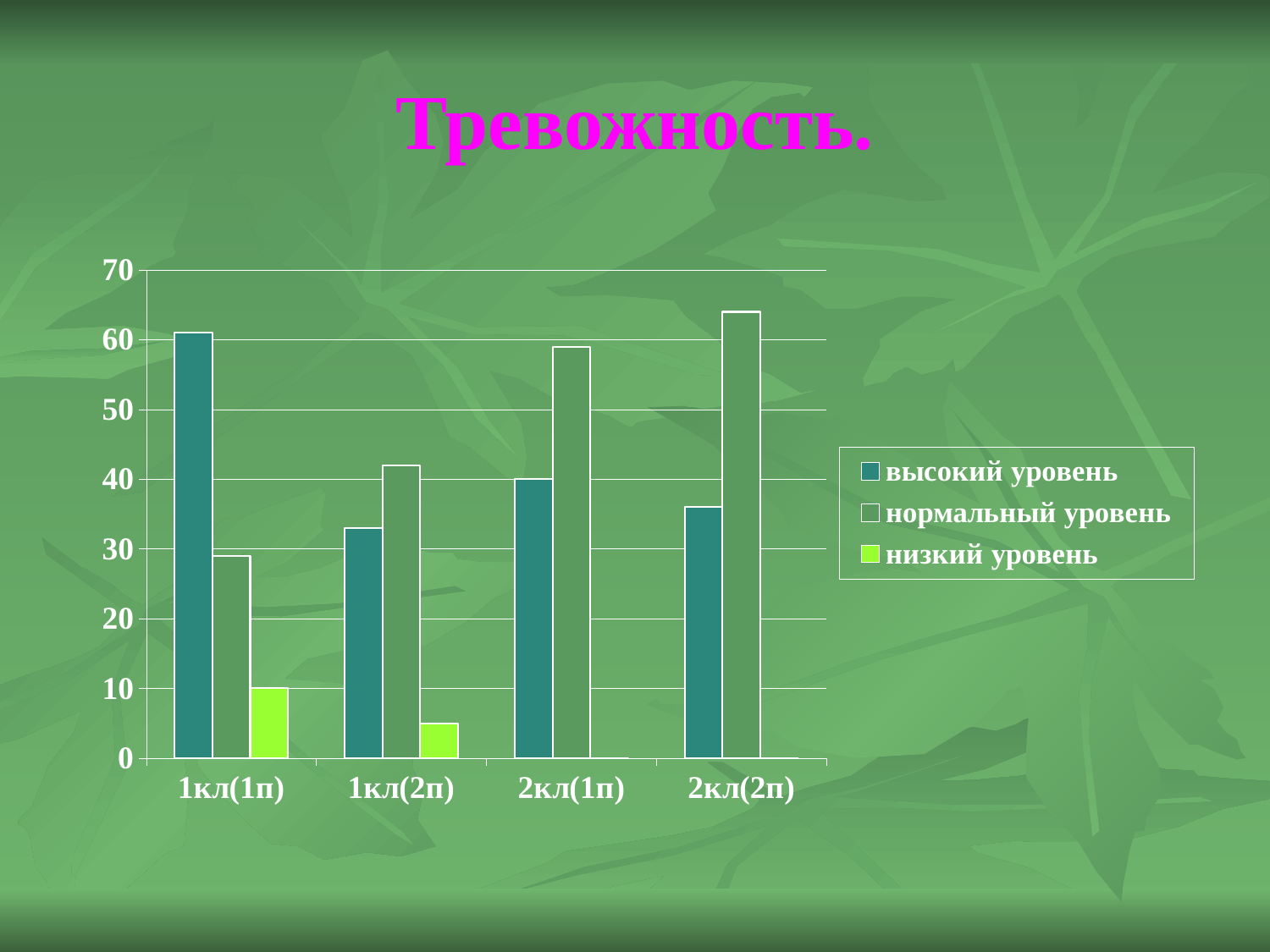
Is the value for низкий уровень in 1кл(2п) greater or less than 10? less Which category has the highest value for высокий уровень? 1кл(1п) How many categories are shown on the x axis? 4 What kind of chart is shown on the slide? bar chart In 1кл(1п), which is larger: высокий уровень or нормальный уровень? высокий уровень Does the value for нормальный уровень rise or fall from 1кл(1п) to 2кл(2п)? rises How many series does the legend list? 3 In 1кл(2п), which is larger: высокий уровень or нормальный уровень? нормальный уровень Is the value for высокий уровень in 1кл(1п) greater or less than 50? greater What is the title of the chart? Тревожность. Which category has the highest value for нормальный уровень? 2кл(2п)